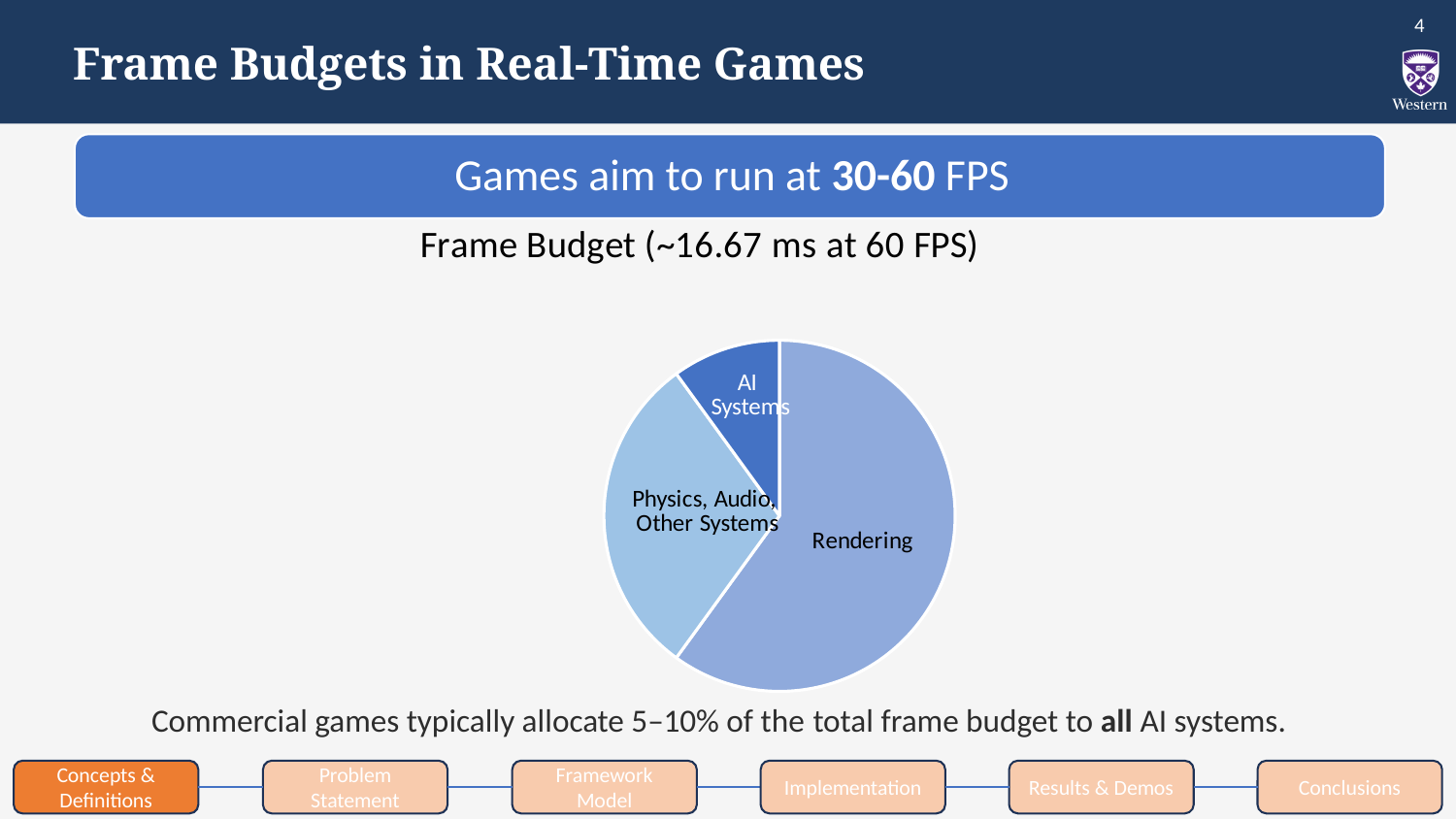
Which slice is larger: Rendering or Physics, Audio, Other Systems? Rendering Which slice of the pie chart is the smallest? AI Systems Which slice of the pie chart is the largest? Rendering Which slice is smaller: Rendering or AI Systems? AI Systems How many slices does the pie chart have? 3 What kind of chart is shown on the slide? pie chart Which slice of the pie chart is drawn in the darkest blue? AI Systems Which slice is larger: AI Systems or Physics, Audio, Other Systems? Physics, Audio, Other Systems What is the title of the pie chart? Frame Budget (~16.67 ms at 60 FPS)